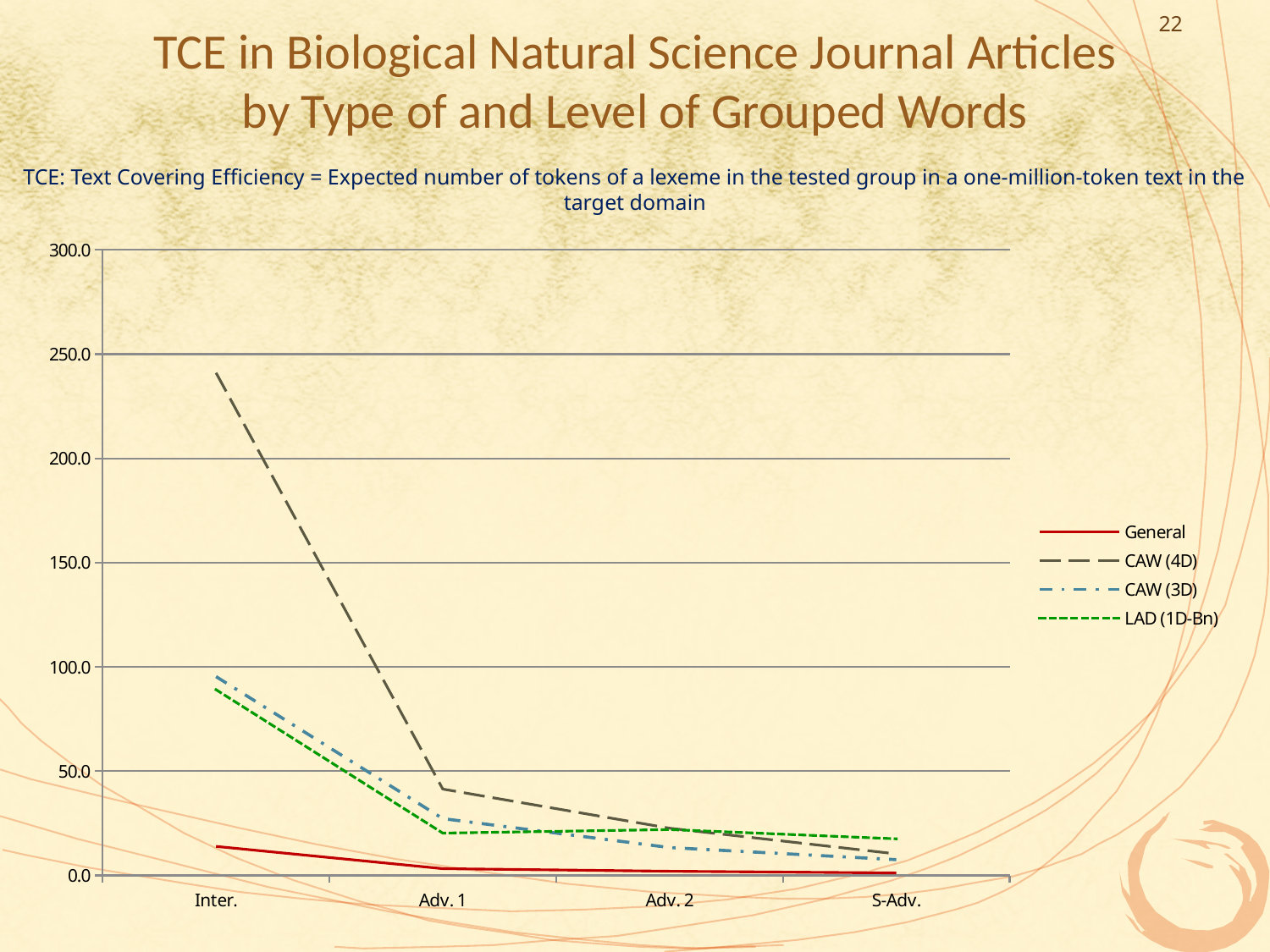
Which is larger at Inter., the value for CAW (4D) or the value for General? CAW (4D) Is the value for CAW (4D) at Inter. greater or less than 200.0? greater Does the CAW (4D) series rise or fall from Inter. to S-Adv.? fall Is the value for General at Inter. greater or less than 50.0? less Which series has the lowest value at Inter.? General What kind of chart is shown on the slide? line chart How many series does the legend list? 4 Which series has the highest value at Inter.? CAW (4D) Which series is drawn with a solid red line in the legend? General Is the value for CAW (4D) at Adv. 1 greater or less than 100.0? less How many categories are shown along the x axis? 4